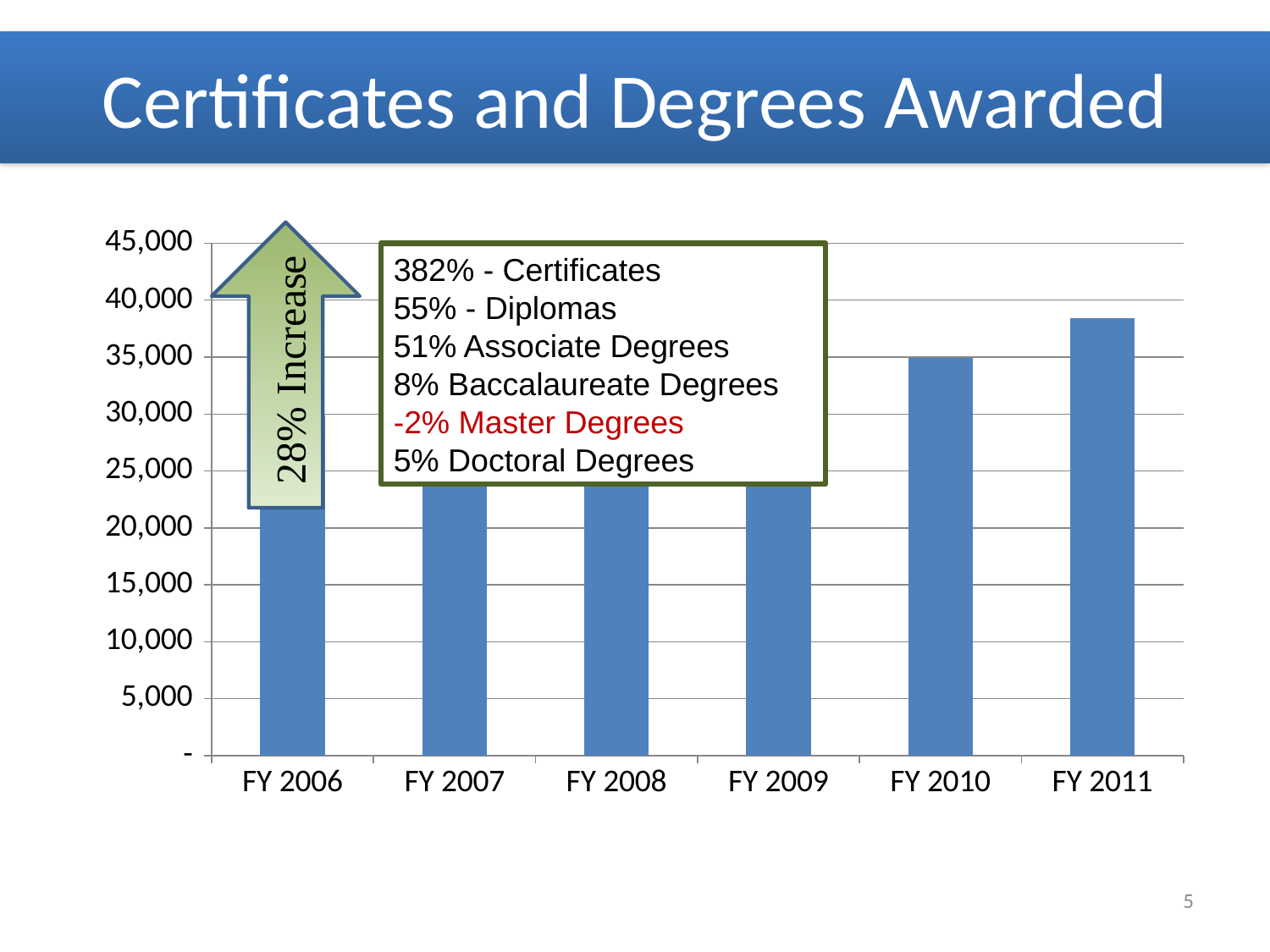
Is the value for FY 2011 greater or less than 40,000? less Does the value rise or fall from FY 2010 to FY 2011? rise Is the value for FY 2010 greater or less than 30,000? greater What is the title of the slide containing the chart? Certificates and Degrees Awarded How many fiscal years are shown on the x axis of the chart? 6 What kind of chart is shown on the slide? bar chart Is the value for FY 2011 greater or less than 35,000? greater What text is written inside the green arrow on the chart? 28% Increase Which is larger, the value for FY 2010 or the value for FY 2011? FY 2011